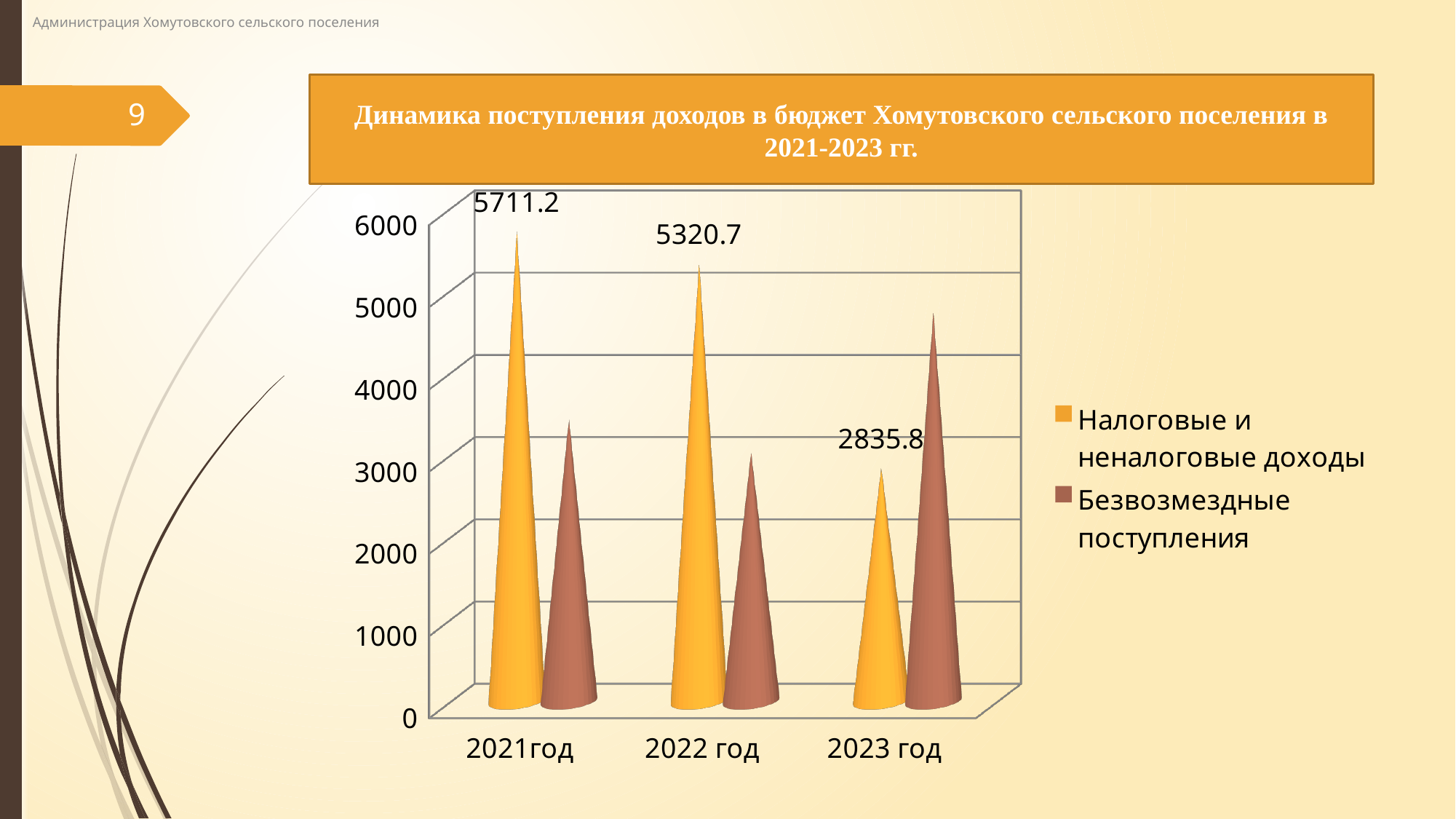
In which year is Налоговые и неналоговые доходы the lowest? 2023 год What is the value of Налоговые и неналоговые доходы for 2023 год? 2835.8 Is the value of Безвозмездные поступления for 2022 год greater or less than 4000? less What is the value of Налоговые и неналоговые доходы for 2022 год? 5320.7 What is the difference between Налоговые и неналоговые доходы in 2021 год and 2022 год? 390.5 In which year is Налоговые и неналоговые доходы the highest? 2021 год How many series does the chart legend list? 2 Is the value of Безвозмездные поступления for 2023 год greater or less than 4000? greater Do the values of Налоговые и неналоговые доходы rise or fall from 2021 год to 2023 год? fall Which is larger in 2023 год: Налоговые и неналоговые доходы or Безвозмездные поступления? Безвозмездные поступления What is the value of Налоговые и неналоговые доходы for 2021 год? 5711.2 How many years are shown on the x axis of the chart? 3